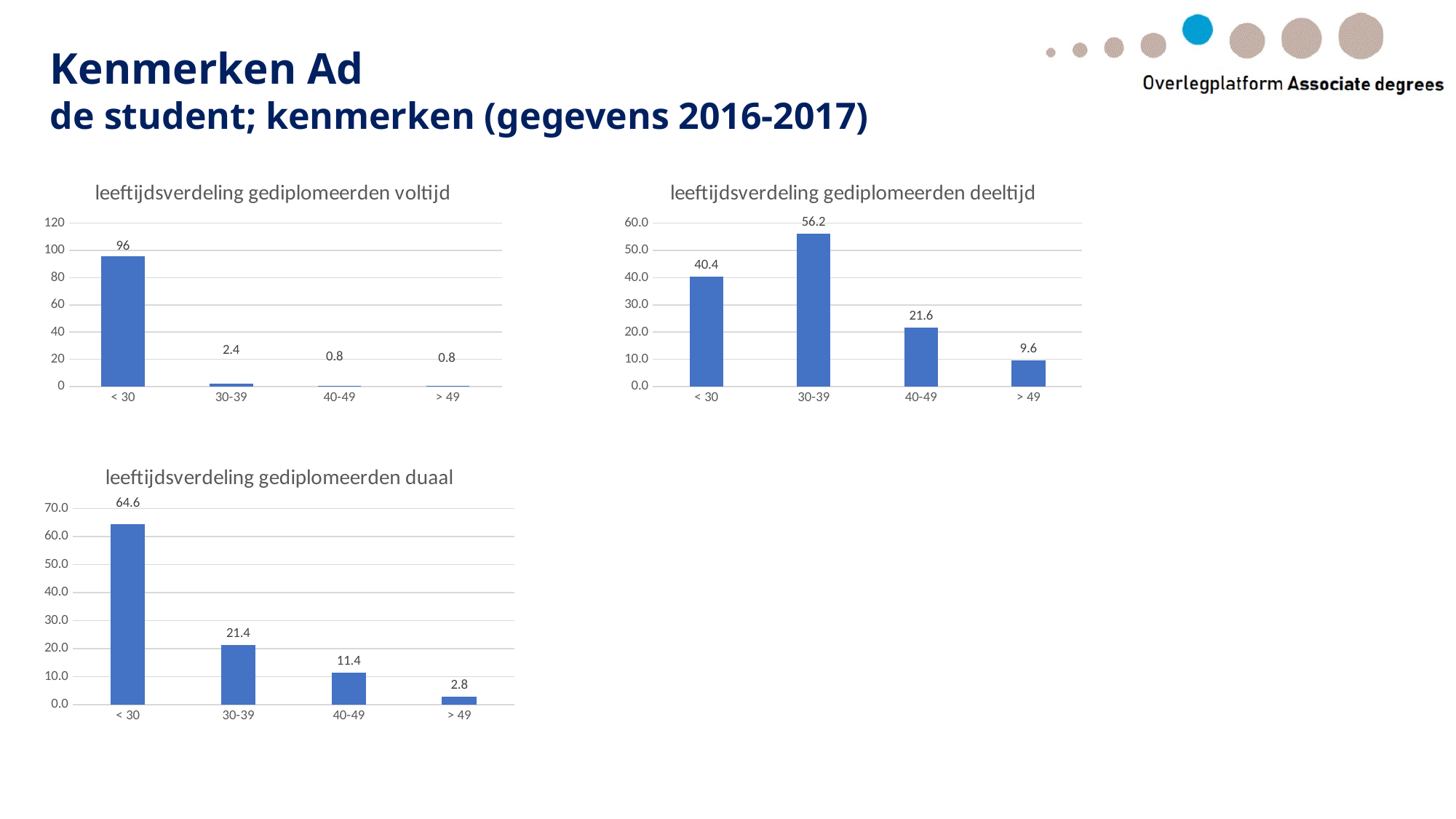
How many categories are shown on the x axis of the chart 'leeftijdsverdeling gediplomeerden duaal'? 4 In the chart 'leeftijdsverdeling gediplomeerden duaal', what is the difference between the values for '< 30' and '30-39'? 43.2 In the chart 'leeftijdsverdeling gediplomeerden deeltijd', which category has the highest value? 30-39 In the chart 'leeftijdsverdeling gediplomeerden deeltijd', what is the difference between the values for '30-39' and '< 30'? 15.8 In the chart 'leeftijdsverdeling gediplomeerden voltijd', is the value for '< 30' greater or less than 80? greater In the chart 'leeftijdsverdeling gediplomeerden deeltijd', what is the value for the '30-39' category? 56.2 What kind of chart is 'leeftijdsverdeling gediplomeerden voltijd'? Bar chart In the chart 'leeftijdsverdeling gediplomeerden duaal', what is the value for the '40-49' category? 11.4 In the chart 'leeftijdsverdeling gediplomeerden voltijd', what is the value for the '< 30' category? 96 In the chart 'leeftijdsverdeling gediplomeerden deeltijd', which is larger: the value for '40-49' or the value for '> 49'? 40-49 In the chart 'leeftijdsverdeling gediplomeerden duaal', do the values rise or fall from '< 30' to '> 49'? Fall In the chart 'leeftijdsverdeling gediplomeerden duaal', which category has the lowest value? > 49